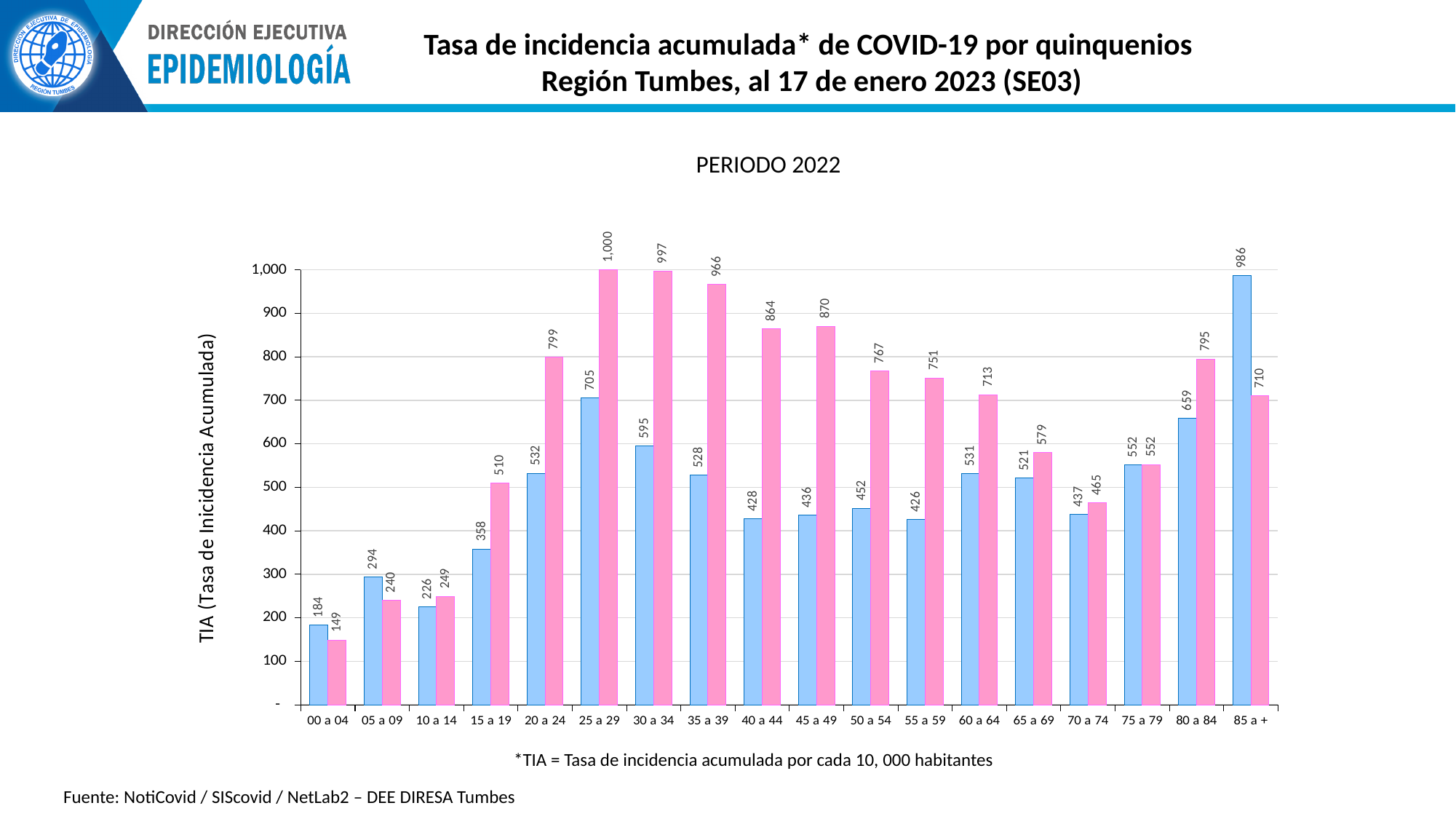
What is the difference between the pink and blue bars for the 20 a 24 age group? 267 For the 85 a + age group, which bar is larger, the blue or the pink? blue Which age group has the lowest pink bar? 00 a 04 How many age groups are shown on the x axis? 18 What is the value of the pink bar for the 40 a 44 age group? 864 What is the title shown above the chart? PERIODO 2022 What is the value of both bars for the 75 a 79 age group? 552 What is the value of the blue bar for the 25 a 29 age group? 705 Which age group has the highest pink bar? 25 a 29 Which age group has the highest blue bar? 85 a + What kind of chart is shown on the slide? bar chart Is the value of the pink bar for the 30 a 34 age group greater or less than 900? greater